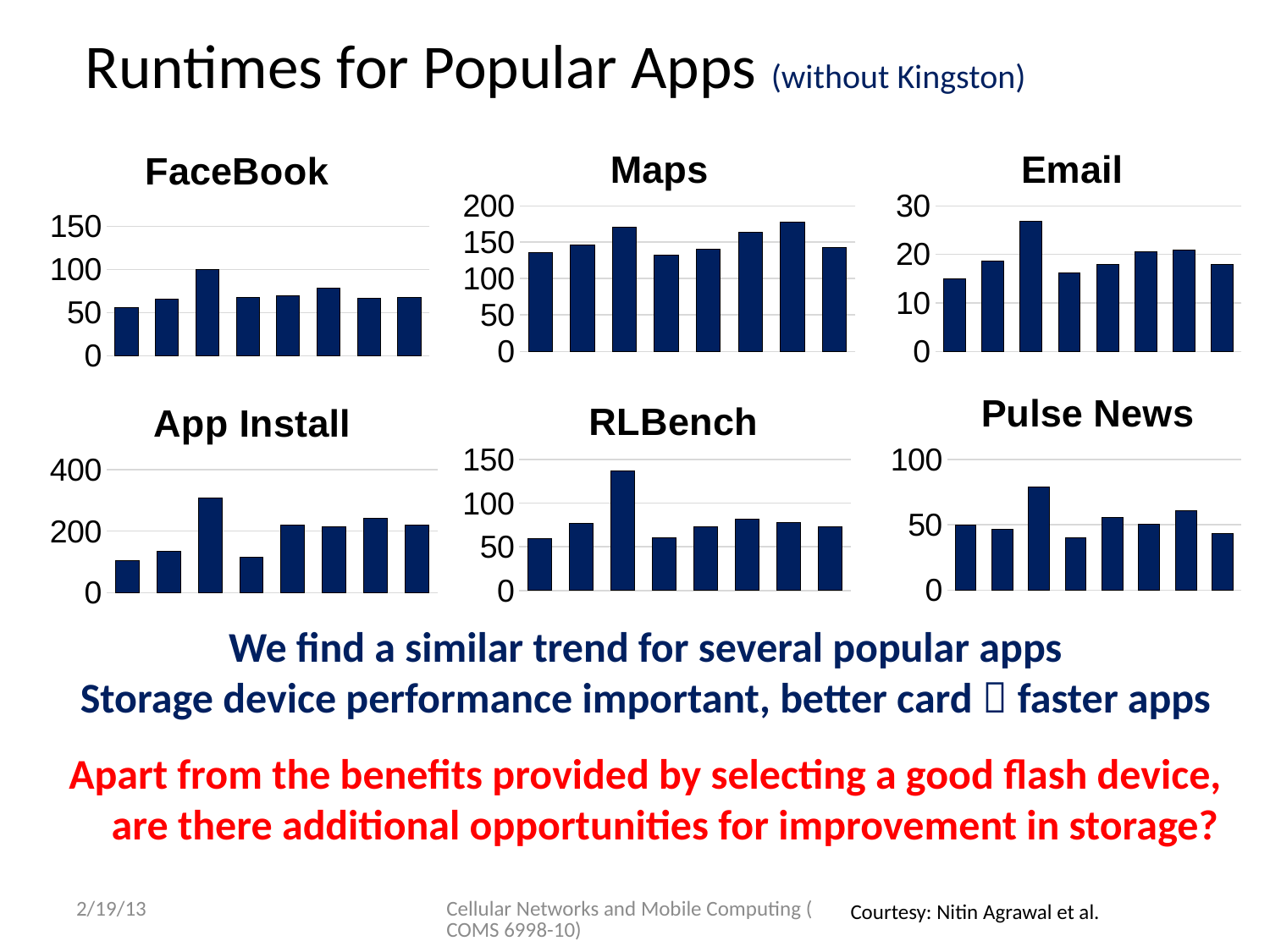
How many bars does the Maps chart have? 8 What is the highest value shown on the vertical axis of the App Install chart? 400 What kind of chart is the FaceBook chart? bar chart In the Pulse News chart, is the value of the tallest bar greater or less than 50? greater In the App Install chart, is the value of the tallest bar greater or less than 200? greater In the RLBench chart, is the value of the tallest bar greater or less than 100? greater How many charts are shown on the slide? 6 What is the title of the chart in the top-right position on the slide? Email In the App Install chart, which bar by position from the left is the tallest? the third bar